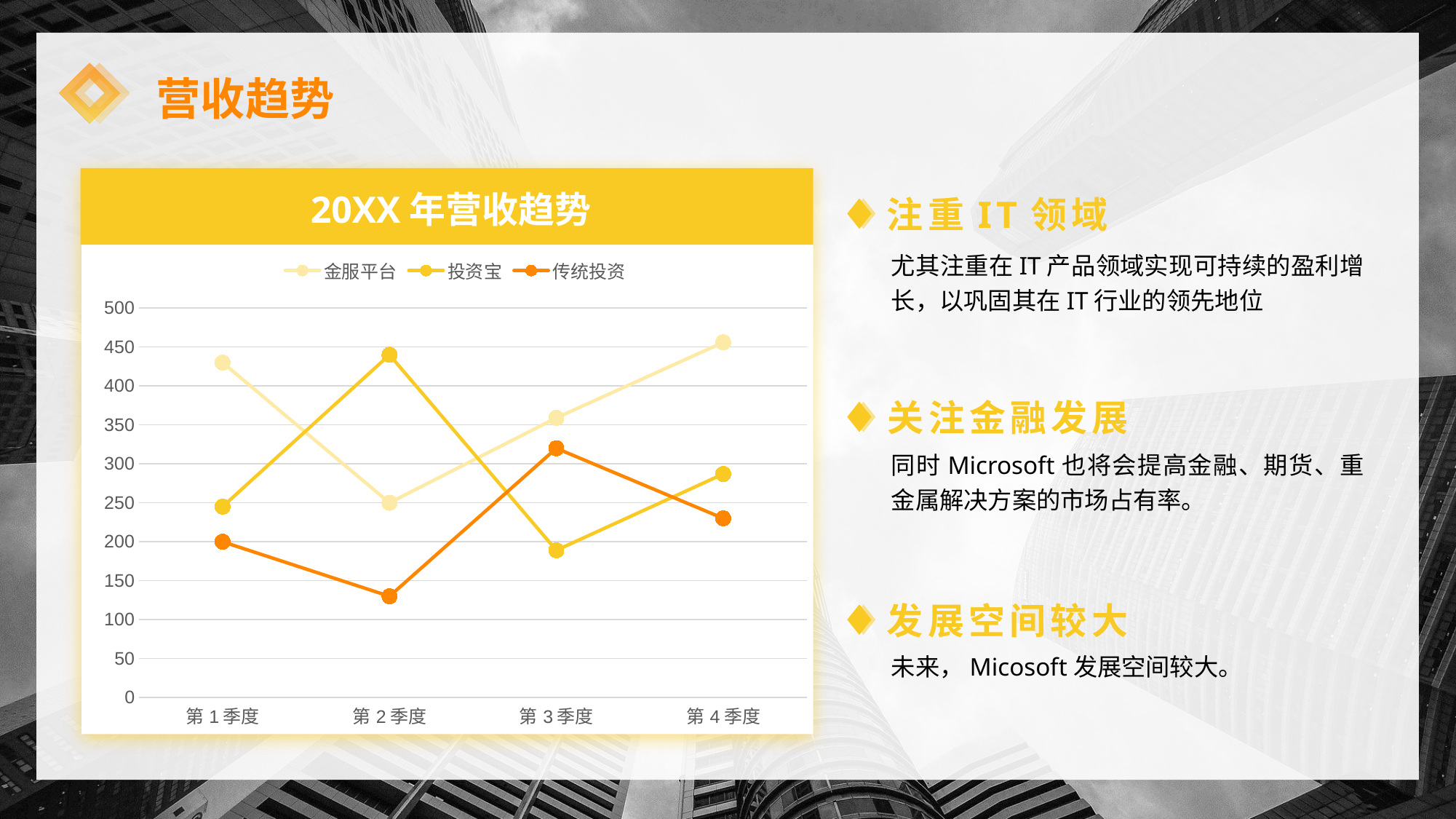
What kind of chart is shown on the slide? line chart Is the value for 传统投资 in 第 2 季度 greater or less than 150? less What is the title of the chart? 20XX 年营收趋势 Is the value for 金服平台 in 第 1 季度 greater or less than 400? greater How many series does the chart legend list? 3 In 第 1 季度, which series has the larger value, 金服平台 or 投资宝? 金服平台 In which quarter does 投资宝 reach its highest value? 第 2 季度 Does the value for 金服平台 rise or fall from 第 2 季度 to 第 4 季度? rise Is the value for 传统投资 in 第 3 季度 greater or less than 300? greater In which quarter does 金服平台 have its lowest value? 第 2 季度 How many quarters are shown on the x axis of the chart? 4